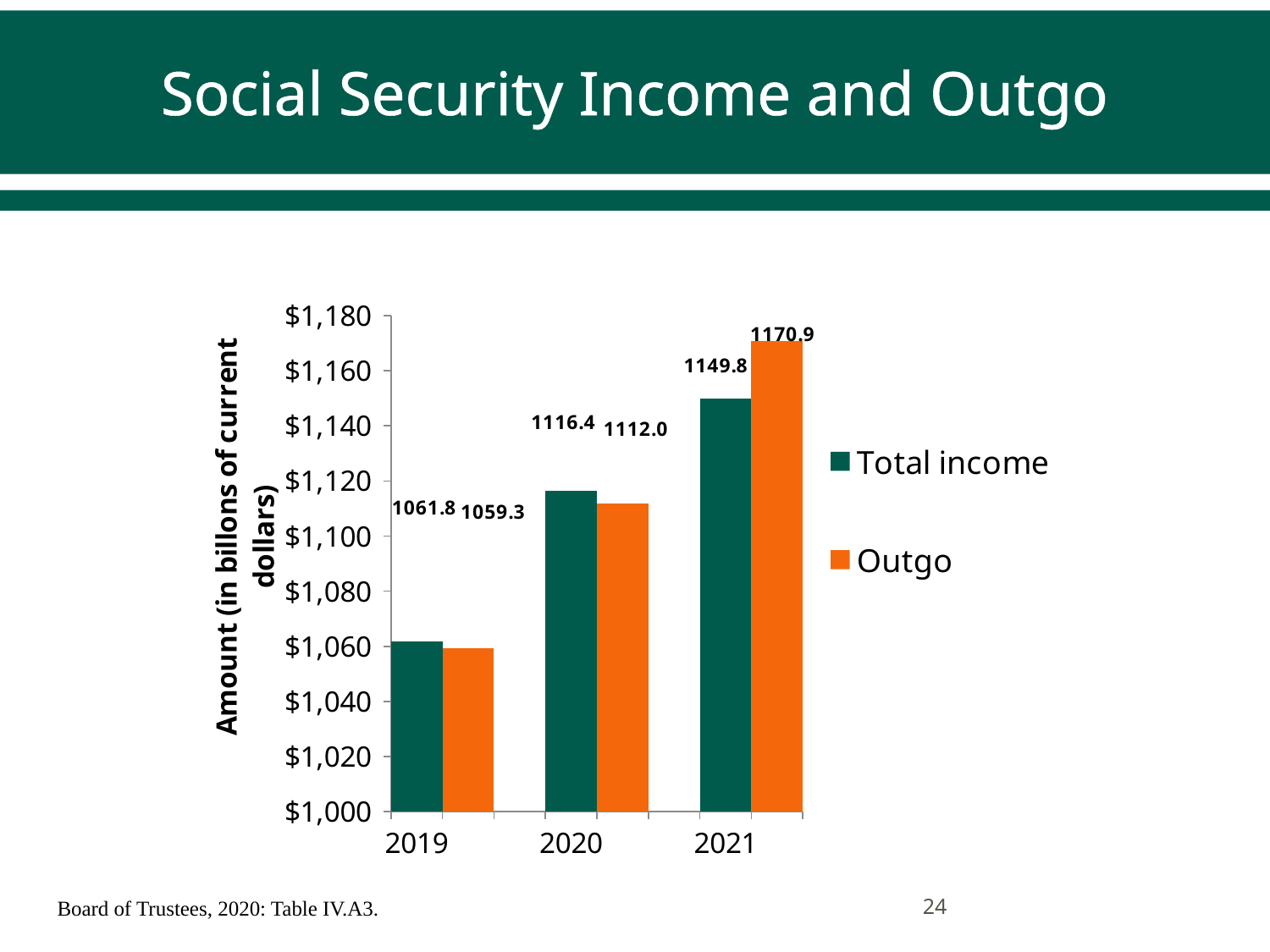
What is the Outgo value for 2021? 1170.9 Is the Total income value for 2019 greater or less than $1,080? less What kind of chart is shown on the slide? Bar chart Does Outgo rise or fall from 2019 to 2021? Rise How many years are shown on the x axis? 3 How many series does the legend list? 2 What is the difference between Outgo and Total income in 2021? 21.1 Which year has the highest Total income? 2021 Which year has the lowest Outgo? 2019 What is the Outgo value for 2019? 1059.3 Which is larger in 2020, Total income or Outgo? Total income What is the Total income value for 2020? 1116.4